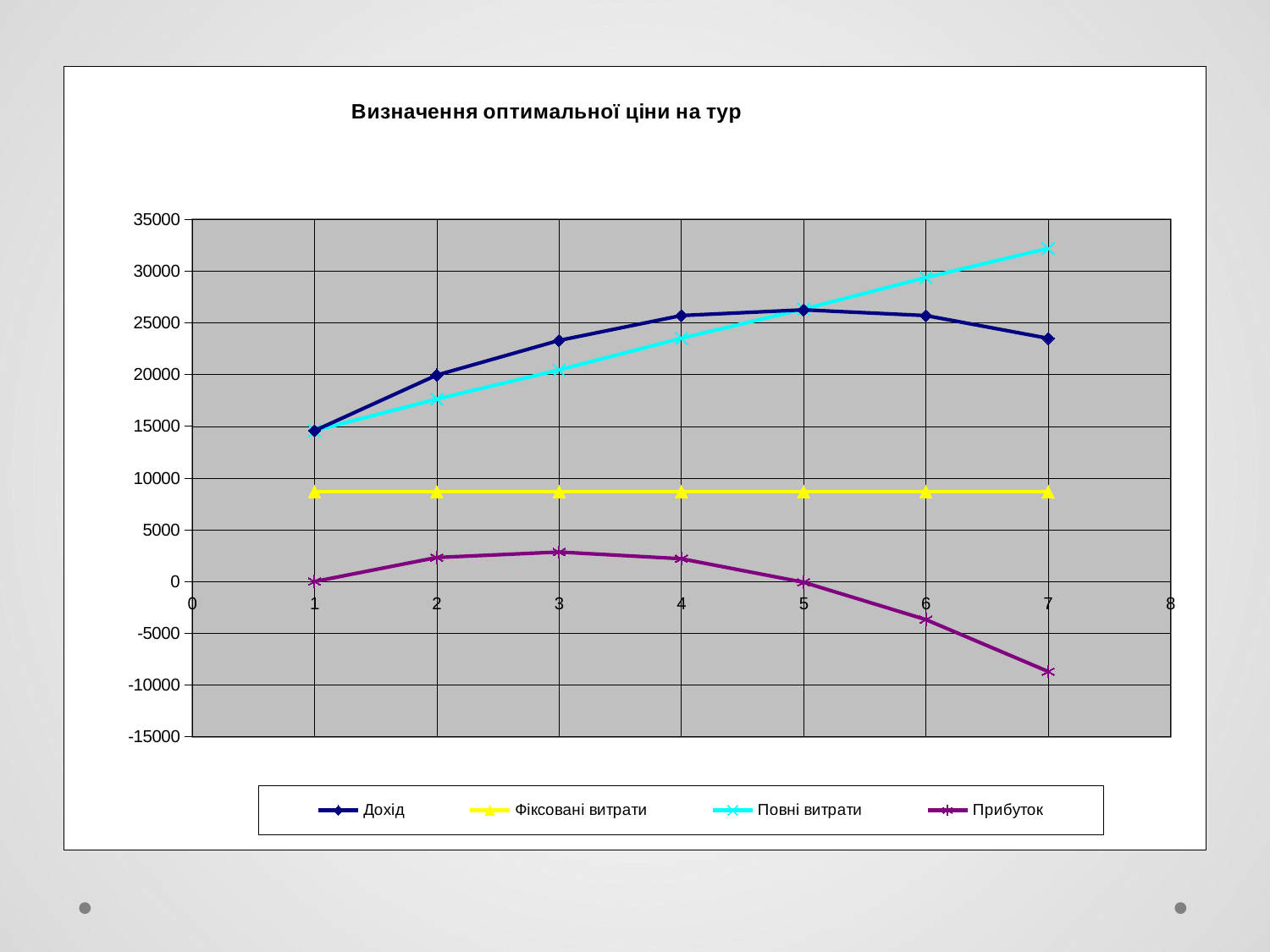
How many series does the legend list? 4 Is the value of Прибуток at x = 7 greater or less than -5000? less At which x value does the Прибуток series reach its highest point? 3 How many data points does the Дохід series have? 7 At which x value does the Дохід series reach its highest point? 5 What kind of chart is shown on the slide? Line chart At x = 7, which is larger: Дохід or Повні витрати? Повні витрати At x = 2, which is larger: Дохід or Повні витрати? Дохід Does the Повні витрати series rise or fall as x increases from 1 to 7? Rises Is the value of Повні витрати at x = 7 greater or less than 30000? greater What is the title of the chart? Визначення оптимальної ціни на тур At which x value is the Прибуток series lowest? 7